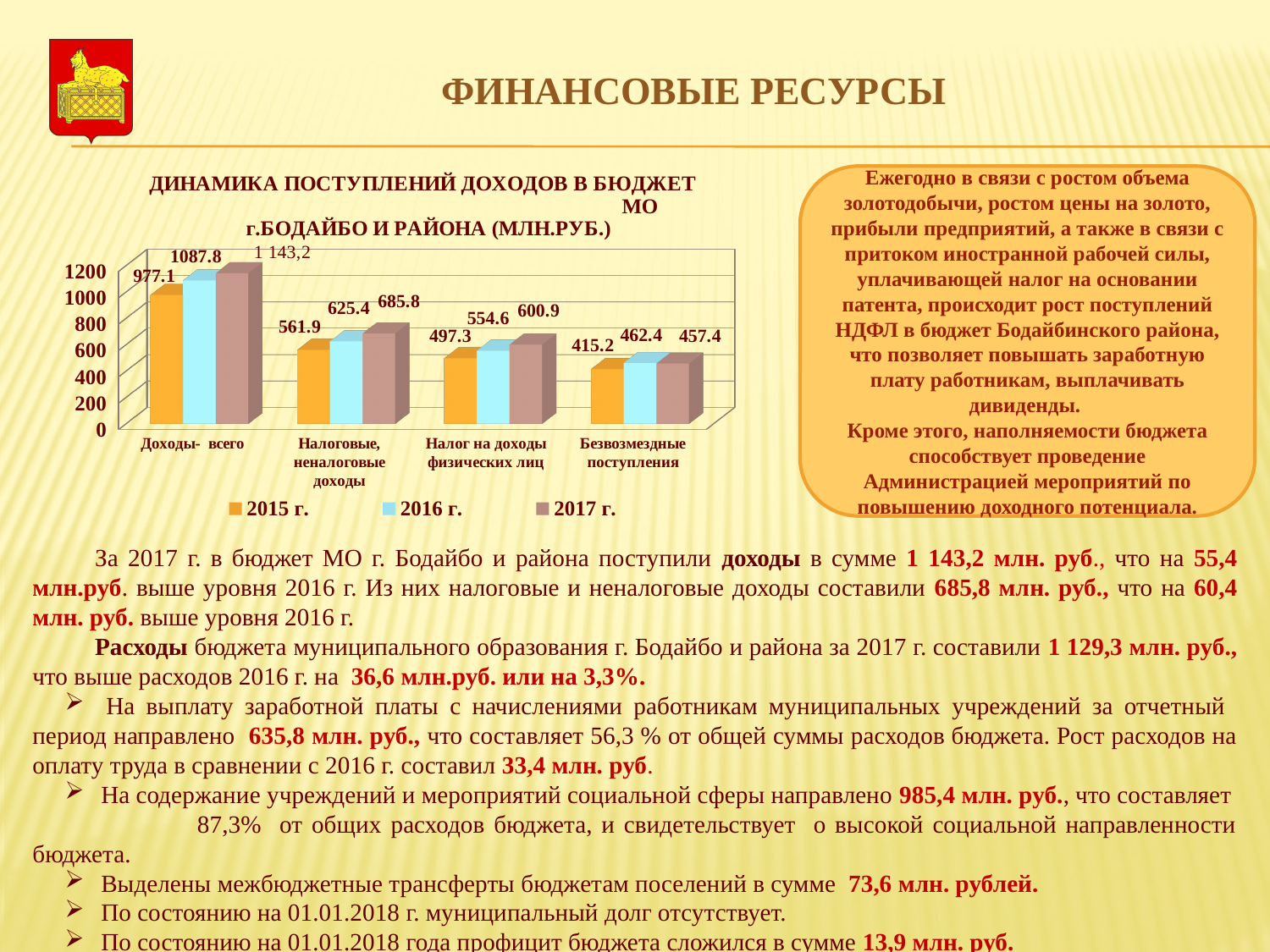
What type of chart is shown on the slide? Bar chart What is the difference between the 2016 г. and 2015 г. values in the category 'Налоговые, неналоговые доходы'? 63.5 What is the value for 2017 г. in the category 'Безвозмездные поступления'? 457.4 Do the values for 'Налог на доходы физических лиц' rise or fall from 2015 г. to 2017 г.? Rise How many categories are shown on the x axis of the chart? 4 Which category has the lowest value for 2015 г.? Безвозмездные поступления What is the value for 2016 г. in the category 'Налог на доходы физических лиц'? 554.6 In the category 'Безвозмездные поступления', which is larger: the value for 2016 г. or for 2017 г.? 2016 г. Which category has the highest value for 2017 г.? Доходы - всего How many series does the chart legend list? 3 What is the value for 2015 г. in the category 'Доходы - всего'? 977.1 What is the value for 2017 г. in the category 'Налоговые, неналоговые доходы'? 685.8